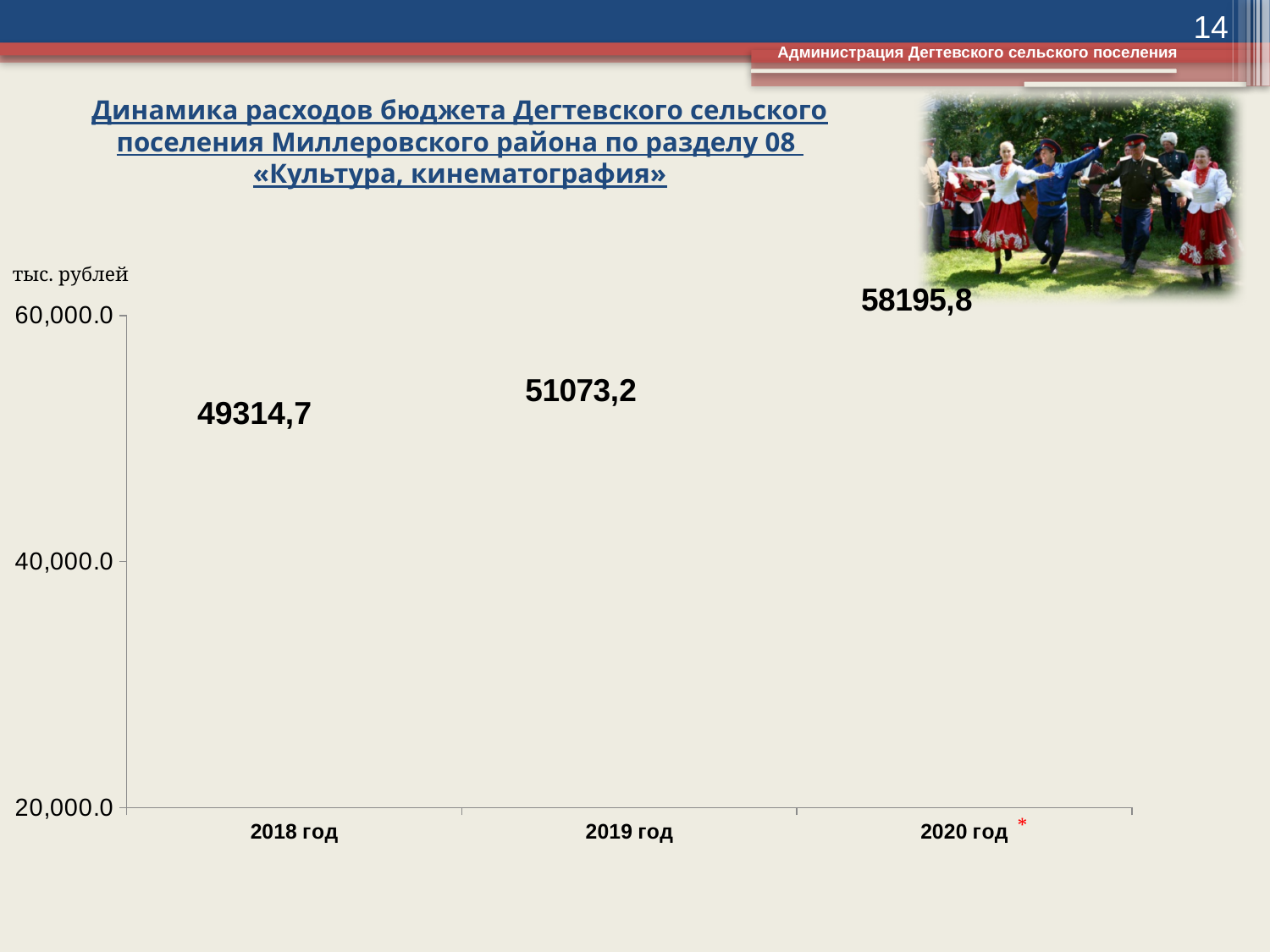
What is the value for 2019 год? 51073,2 Which year has the lowest value? 2018 год What is the difference between the values for 2020 год and 2019 год? 7122,6 Which is larger, the value for 2019 год or the value for 2020 год? 2020 год What unit is stated for the values on the chart? тыс. рублей Which year has the highest value? 2020 год Is the value for 2020 год greater or less than 40,000.0? greater Do the values rise or fall from 2018 год to 2020 год? rise What is the difference between the values for 2019 год and 2018 год? 1758,5 What is the value for 2018 год? 49314,7 How many years are shown on the x axis? 3 What is the value for 2020 год? 58195,8